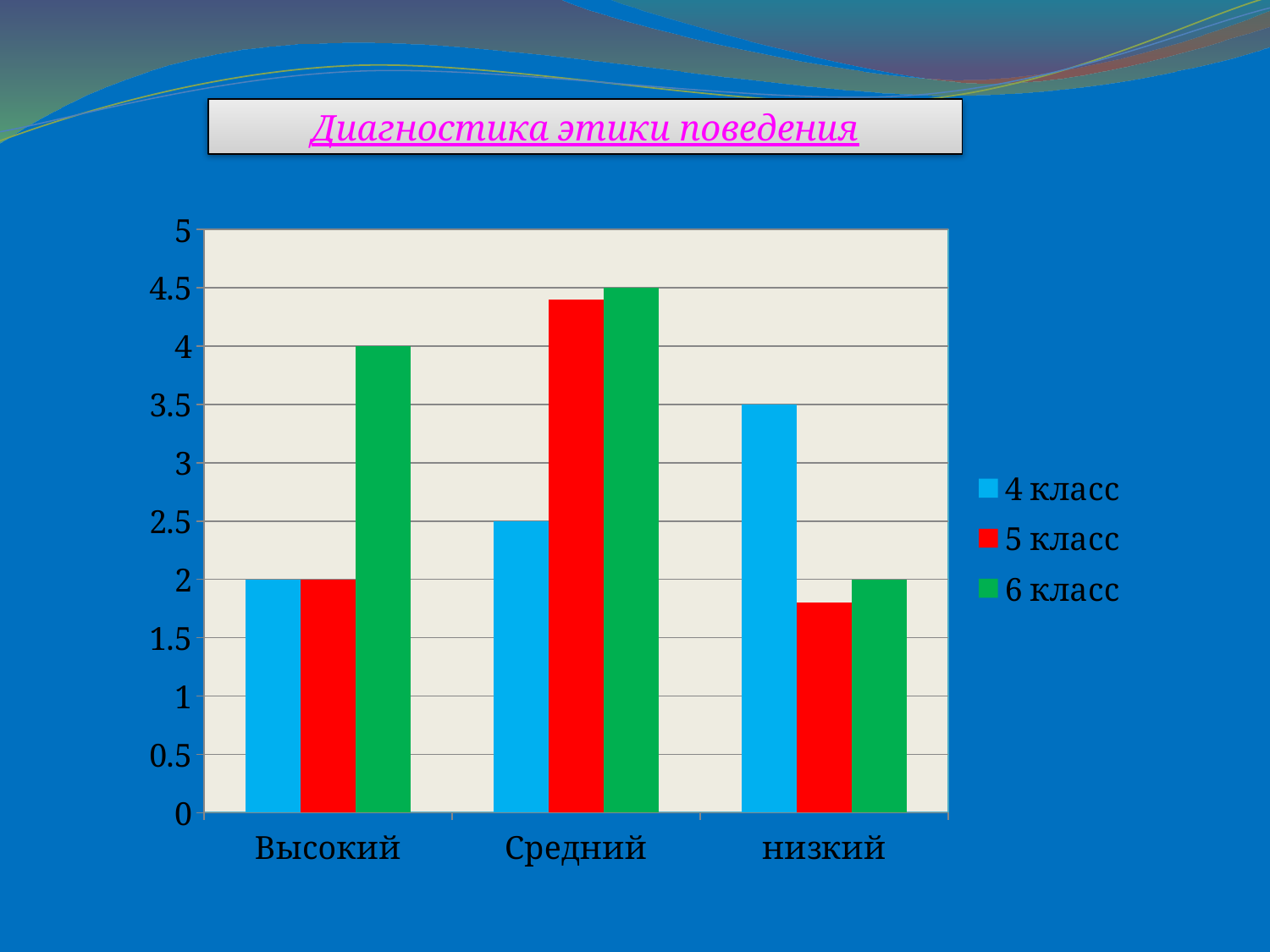
What is the value for 4 класс in the Средний category? 2.5 How many categories are shown on the x axis? 3 What is the value for 4 класс in the низкий category? 3.5 What is the difference between the 6 класс and 4 класс values in the Высокий category? 2 What is the value for 6 класс in the Высокий category? 4 Is the value for 5 класс in the Средний category greater or less than 4? greater What kind of chart is shown on the slide? bar chart How many series does the legend list? 3 What is the value for 6 класс in the Средний category? 4.5 Which category has the highest value for 4 класс? низкий Is the value for 5 класс in the низкий category greater or less than 2? less What is the title of the chart? Диагностика этики поведения